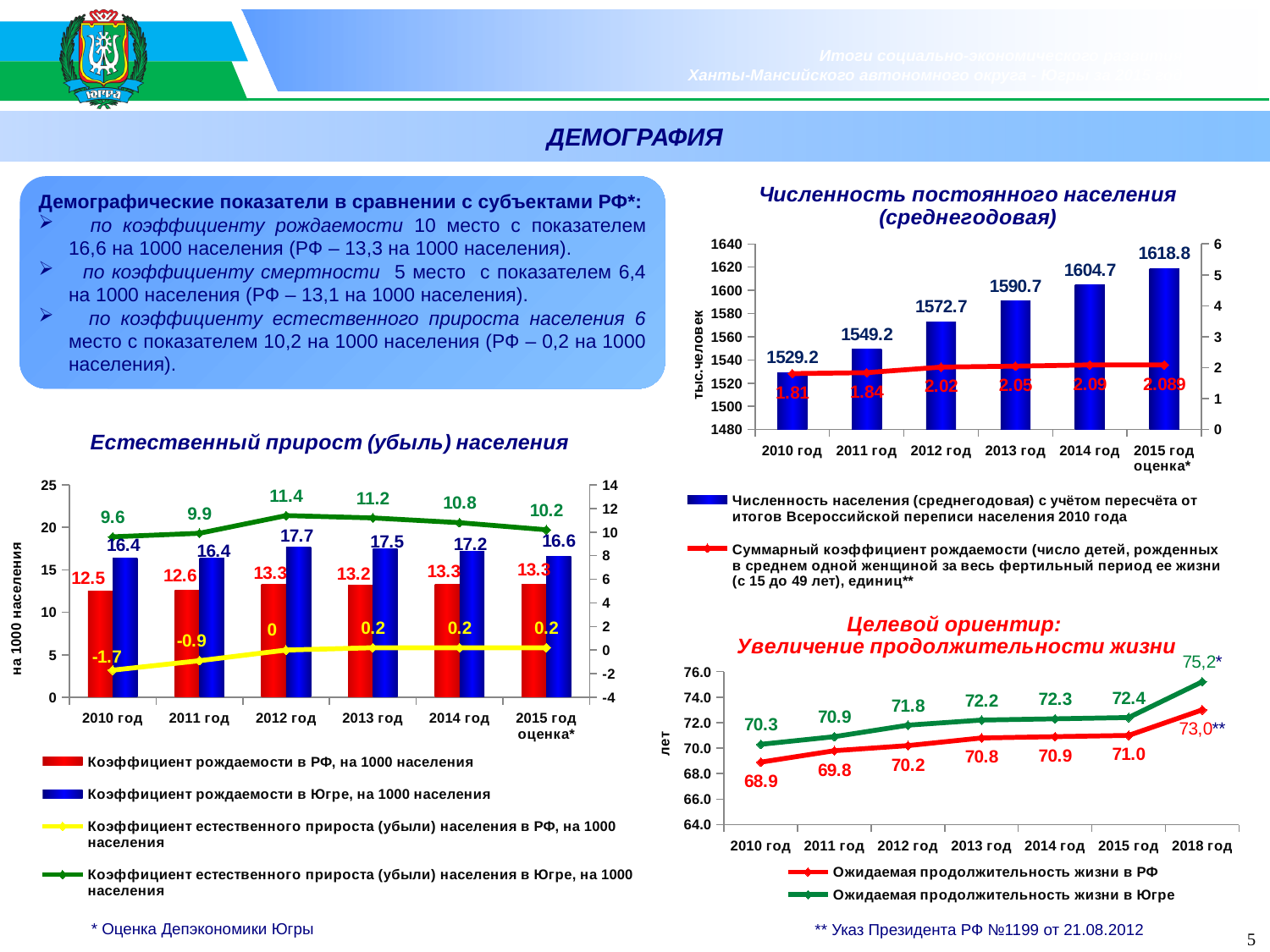
In the chart 'Естественный прирост (убыль) населения', which year has the highest natural growth rate in Югра? 2012 год In the chart 'Численность постоянного населения (среднегодовая)', what is the total fertility rate (Суммарный коэффициент рождаемости) for 2012 год? 2.02 In the chart 'Естественный прирост (убыль) населения', what is the natural growth rate in РФ for 2010 год? -1.7 In the chart 'Целевой ориентир: Увеличение продолжительности жизни', what is the difference between life expectancy in Югра and in РФ for 2013 год? 1.4 In the chart 'Численность постоянного населения (среднегодовая)', by how much did the population grow from 2010 год to 2015 год оценка*? 89.6 In the chart 'Численность постоянного населения (среднегодовая)', does the population rise or fall from 2010 to 2015? rise In the chart 'Целевой ориентир: Увеличение продолжительности жизни', what is the expected life expectancy in Югра for 2018 год? 75,2 In the chart 'Естественный прирост (убыль) населения', what is the birth rate in Югра (Коэффициент рождаемости в Югре) for 2012 год? 17.7 In the chart 'Целевой ориентир: Увеличение продолжительности жизни', how many years are shown on the x axis? 7 In the chart 'Численность постоянного населения (среднегодовая)', what is the average annual population for 2013 год? 1590.7 In the chart 'Естественный прирост (убыль) населения', how many series does the legend list? 4 In the chart 'Численность постоянного населения (среднегодовая)', which year has the highest population bar? 2015 год оценка*